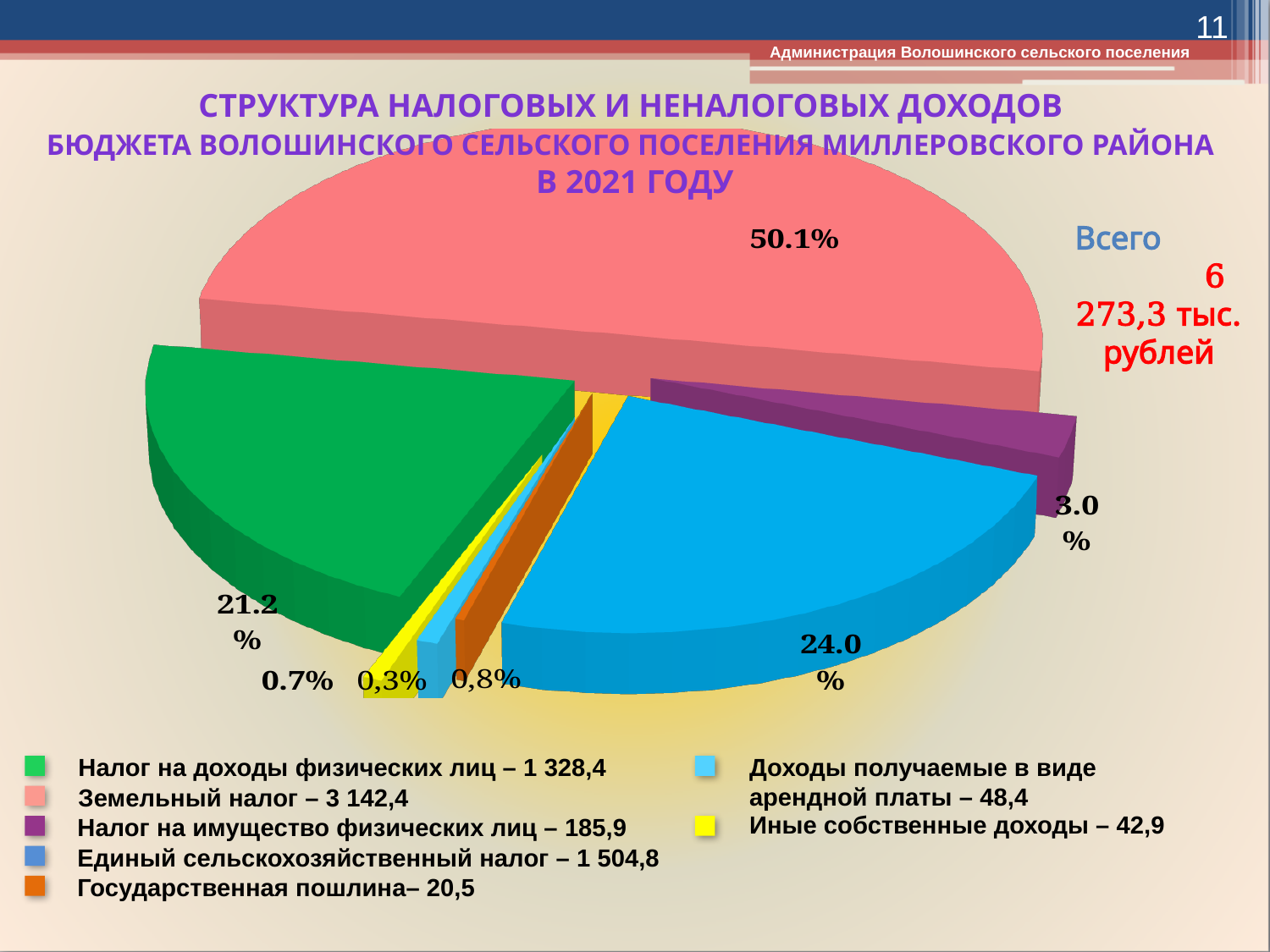
Which is larger, Единый сельскохозяйственный налог or Налог на доходы физических лиц? Единый сельскохозяйственный налог What share of the pie does Земельный налог take? 50.1% How many categories does the legend of the pie chart list? 7 What share of the pie does Единый сельскохозяйственный налог take? 24.0% What value is given in the legend for Единый сельскохозяйственный налог? 1 504,8 Which category has the largest slice of the pie? Земельный налог What value is given in the legend for Налог на доходы физических лиц? 1 328,4 What share of the pie does Налог на доходы физических лиц take? 21.2% Which category has the smallest value in the legend? Государственная пошлина What kind of chart is shown on the slide? Pie chart What total amount (Всего) is shown next to the pie chart? 6 273,3 тыс. рублей